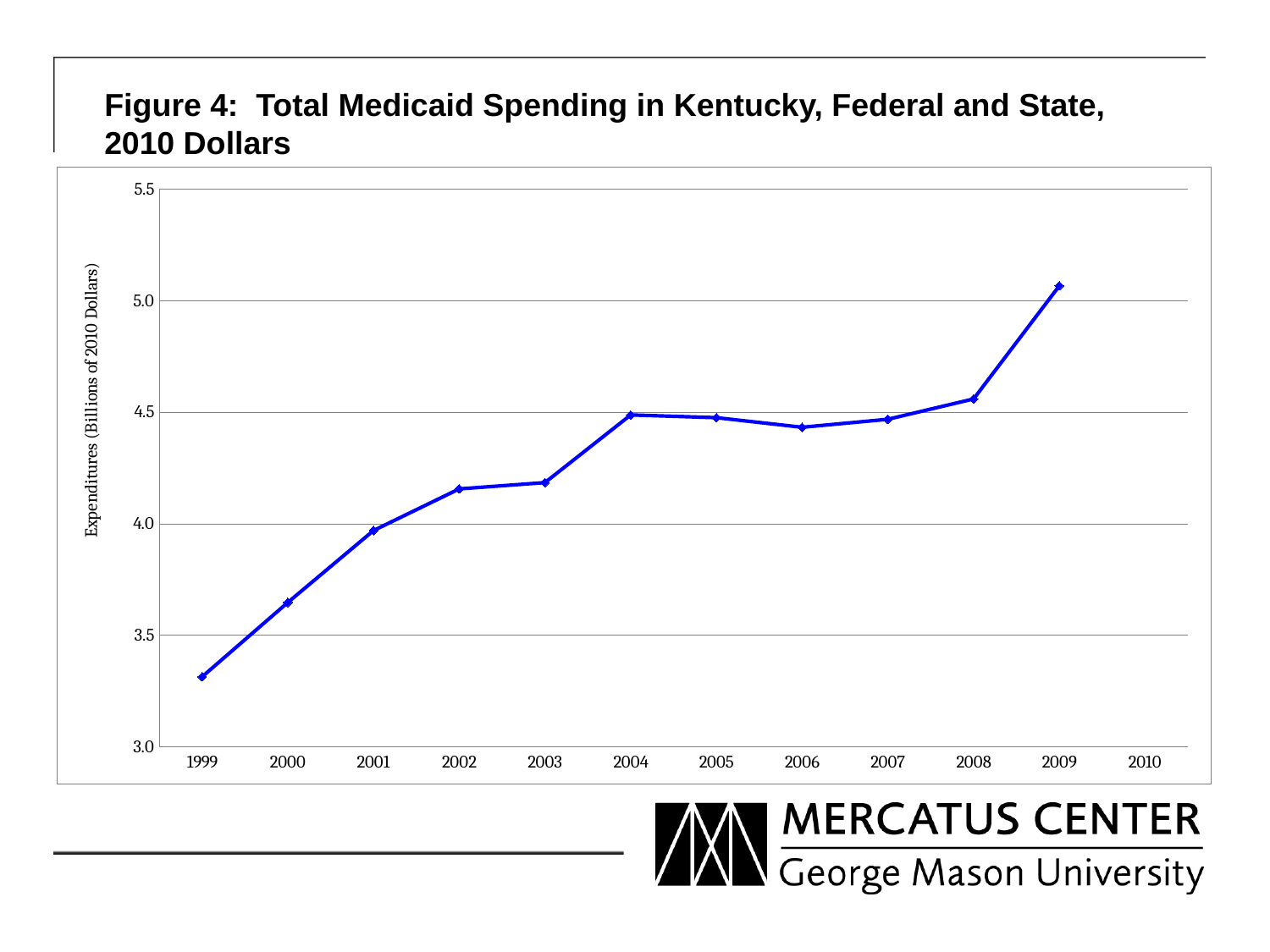
Which year has the highest Medicaid spending value on the chart? 2009 Is the value for 2002 greater or less than 4.0? greater Is the value for 2009 greater or less than 5.0? greater What is the label on the vertical axis of the chart? Expenditures (Billions of 2010 Dollars) Overall, do the values rise or fall from 1999 to 2009? rise Is the value for 1999 greater or less than 3.5? less What kind of chart is shown on the slide? line chart Which year has the larger value, 2001 or 2006? 2006 How many data points are plotted on the line? 11 Which year has the lowest Medicaid spending value on the chart? 1999